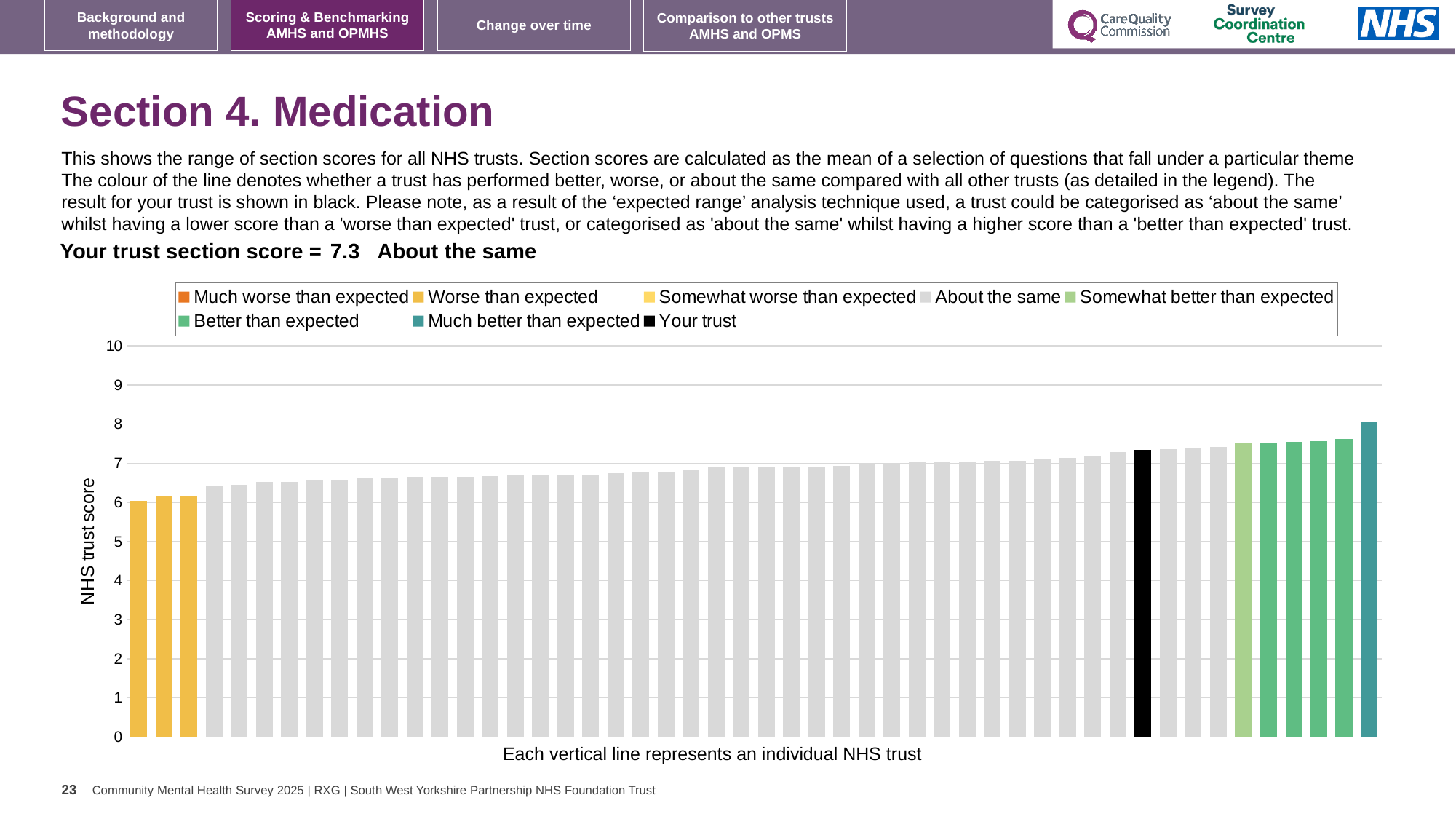
What kind of chart is shown on the slide? bar chart Which legend category does the highest bar belong to? Much better than expected Is the value of the black 'Your trust' bar greater or less than 7? greater What is the label on the vertical axis of the chart? NHS trust score Is the value of the rightmost (highest) bar greater or less than 7? greater How many bars are coloured as 'Worse than expected'? 3 What is the section score for your trust shown on the slide? 7.3 Is the value of the leftmost (lowest) bar greater or less than 5? greater Do the bar values rise or fall from left to right along the x axis? rise How many entries does the chart legend list? 8 Which legend category does the lowest bar belong to? Worse than expected